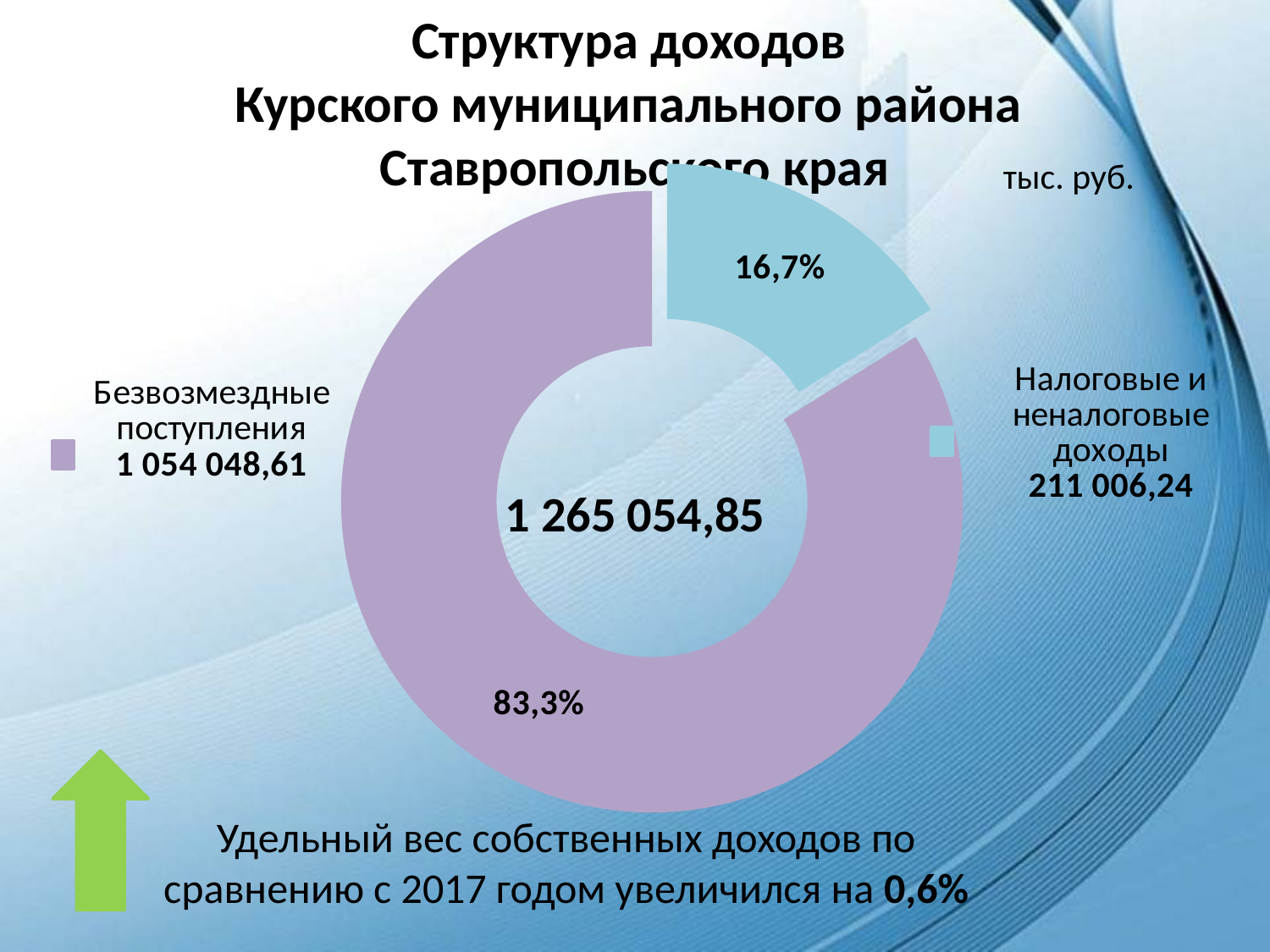
What is the value for Безвозмездные поступления? 1 054 048,61 What is the value for Налоговые и неналоговые доходы? 211 006,24 What is the total value shown in the centre of the chart? 1 265 054,85 Which category has the largest slice? Безвозмездные поступления How many categories does the chart show? 2 What share of the chart does Налоговые и неналоговые доходы represent? 16,7% Which is larger: Безвозмездные поступления or Налоговые и неналоговые доходы? Безвозмездные поступления What share of the chart does Безвозмездные поступления represent? 83,3% What unit of measurement is indicated for the chart values? тыс. руб. What colour is the slice for Налоговые и неналоговые доходы? Light blue Which category has the smallest slice? Налоговые и неналоговые доходы What kind of chart is shown on the slide? Doughnut (pie) chart